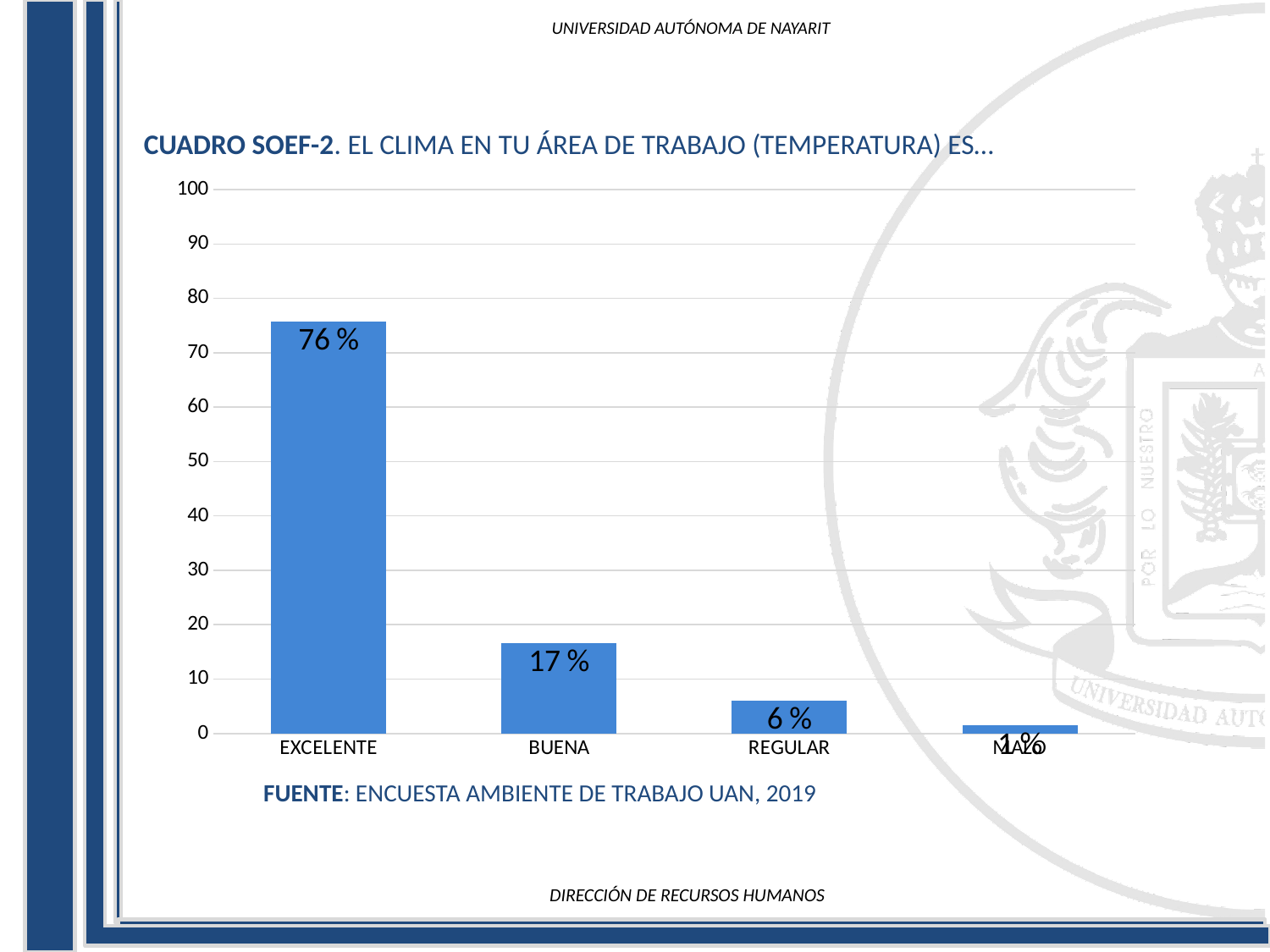
What is the value for BUENA? 17 % What is the value for REGULAR? 6 % Which category has the highest value? EXCELENTE Which is larger, the value for BUENA or the value for REGULAR? BUENA Is the value for EXCELENTE greater or less than 70? greater Do the values rise or fall from left to right along the x axis? fall What kind of chart is shown on the slide? bar chart Which category has the lowest value? MALO What is the difference between the values for BUENA and REGULAR? 11 % What is the value for EXCELENTE? 76 % How many categories are shown on the x axis? 4 What is the difference between the values for EXCELENTE and BUENA? 59 %